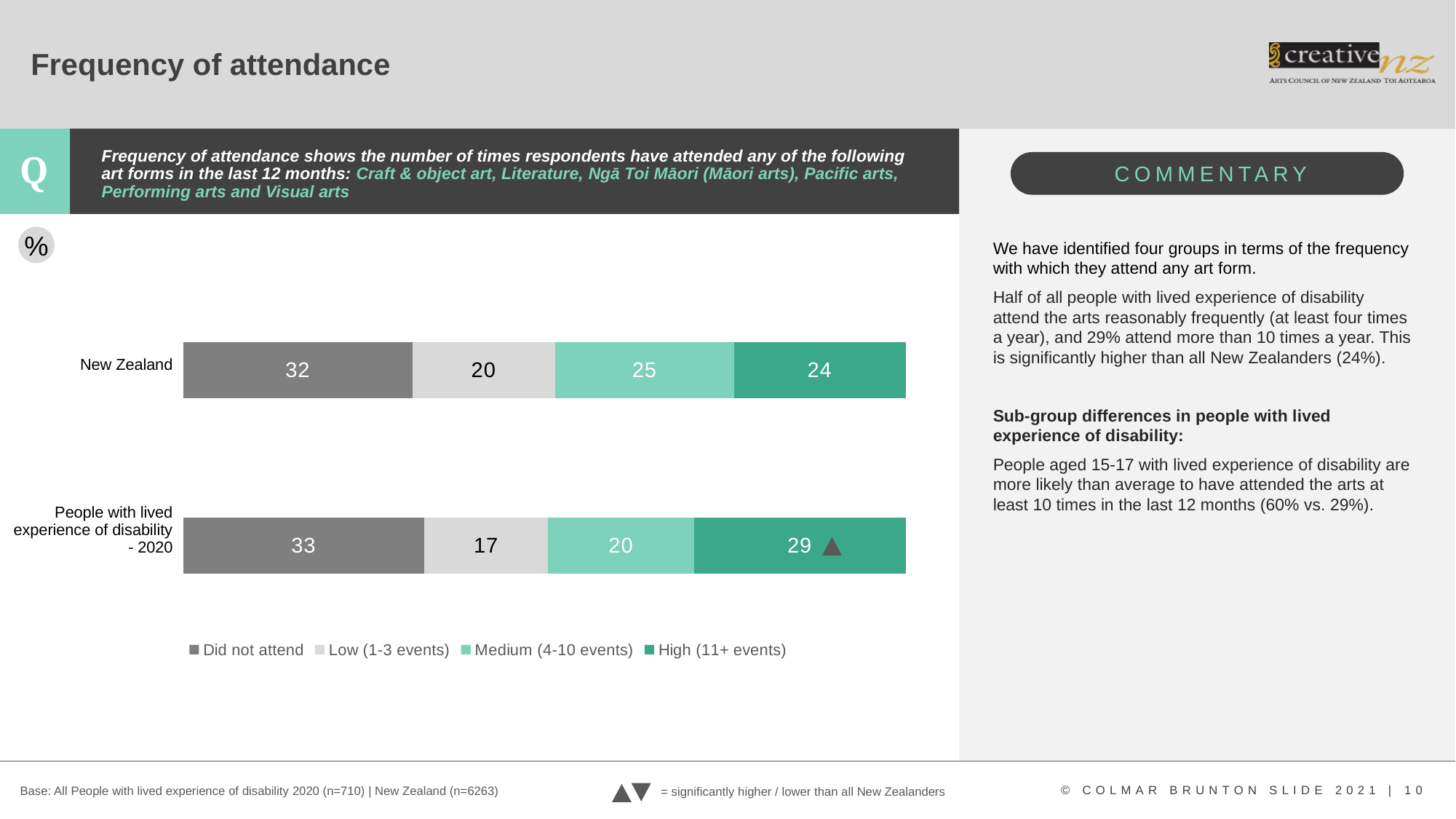
What is the Medium (4-10 events) value for New Zealand? 25 How many series does the legend list? 4 What is the total of the stacked bar for New Zealand? 101 What is the Low (1-3 events) value for People with lived experience of disability - 2020? 17 What is the difference between the High (11+ events) values for People with lived experience of disability - 2020 and New Zealand? 5 What percentage of New Zealand respondents did not attend any art form? 32 What is the High (11+ events) value for People with lived experience of disability - 2020? 29 Which series has the highest value in the New Zealand bar? Did not attend Which series has the lowest value in the People with lived experience of disability - 2020 bar? Low (1-3 events) How many categories (bars) are shown in the chart? 2 Which group has the larger Medium (4-10 events) value, New Zealand or People with lived experience of disability - 2020? New Zealand What kind of chart is shown on the slide? Stacked bar chart